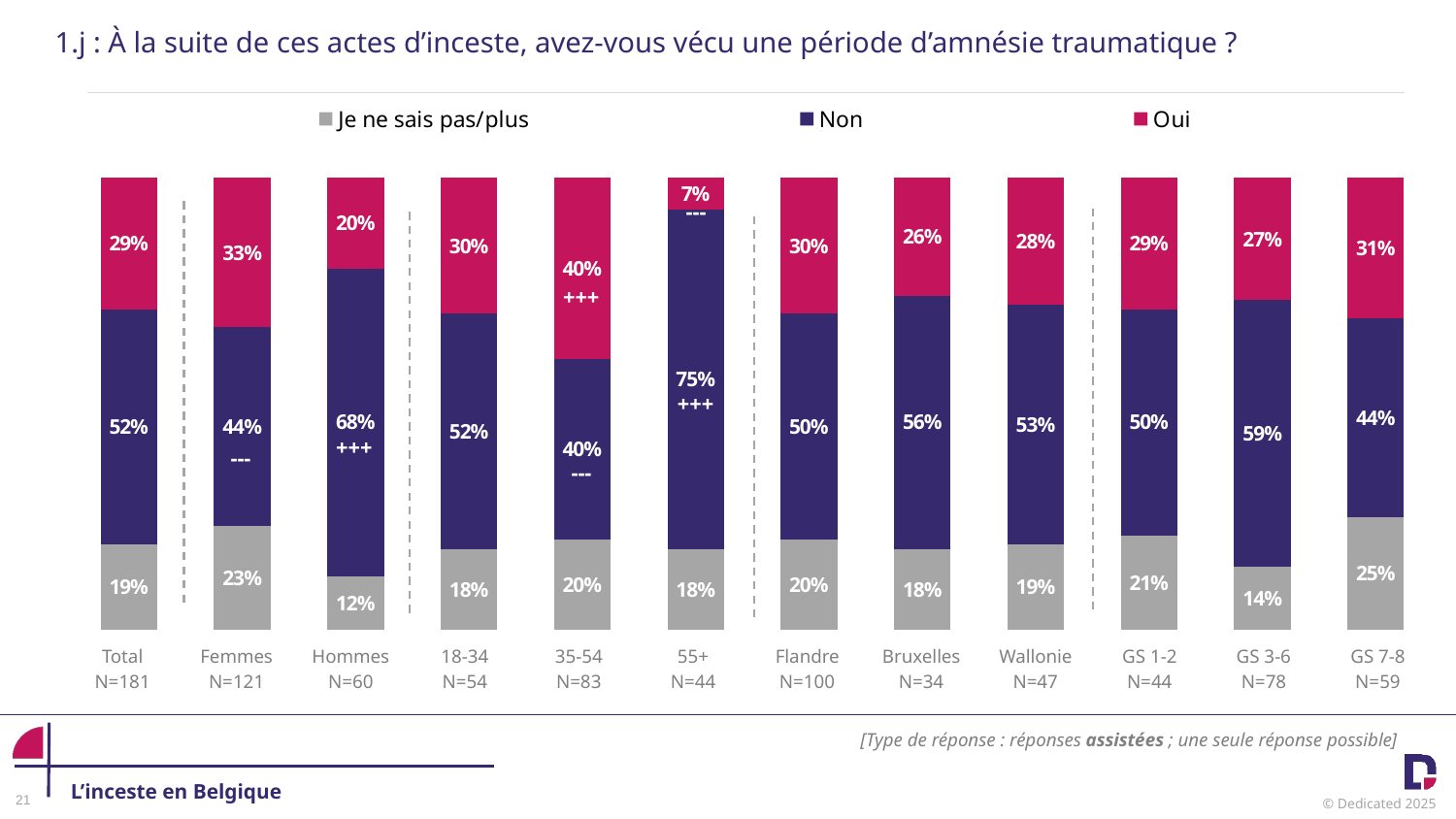
What is the 'Non' value for Hommes (N=60)? 68% What is the 'Je ne sais pas/plus' value for GS 7-8 (N=59)? 25% Which is larger: the 'Non' value for Bruxelles or the 'Non' value for Flandre? Bruxelles What is the 'Oui' value for the Total group (N=181)? 29% What type of chart is shown on the slide? Stacked bar chart What is the difference in percentage points between the 'Oui' value for Femmes and the 'Oui' value for Hommes? 13 percentage points Which category has the highest 'Oui' value? 35-54 Which category has the lowest 'Je ne sais pas/plus' value? Hommes How many series does the legend list? 3 Which category has the lowest 'Oui' value? 55+ What is the total of the three segments in the Total (N=181) bar? 100% How many categories (bars) are shown on the chart? 12